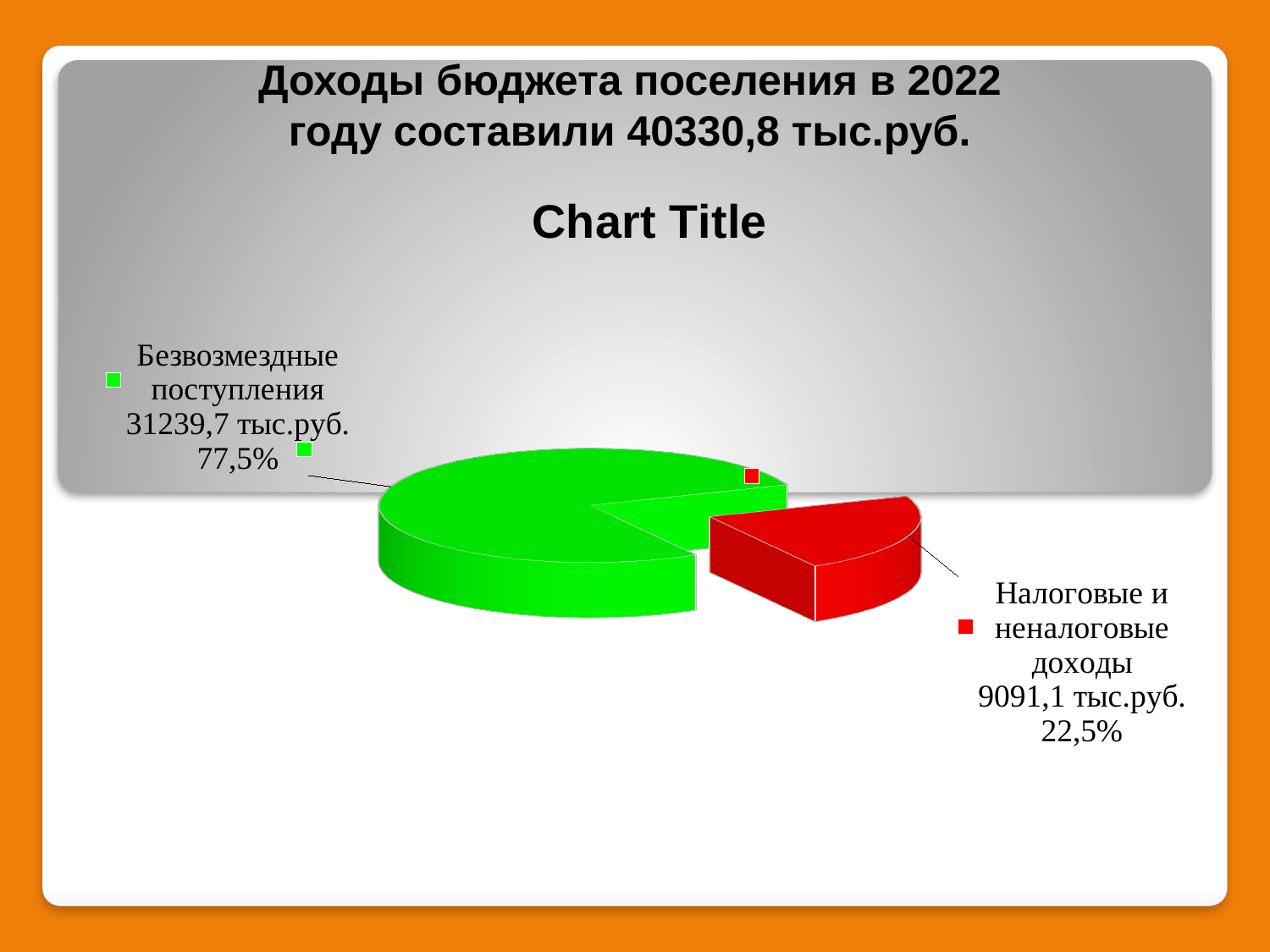
Which is larger: Безвозмездные поступления or Налоговые и неналоговые доходы? Безвозмездные поступления What is the difference in percentage points between the share of Безвозмездные поступления and the share of Налоговые и неналоговые доходы? 55 percentage points What is the title printed above the pie chart? Chart Title Which category has the smallest slice of the pie? Налоговые и неналоговые доходы What colour is the slice for Налоговые и неналоговые доходы? red What share of the pie does Налоговые и неналоговые доходы represent? 22,5% What is the value shown for Безвозмездные поступления? 31239,7 тыс.руб. What kind of chart is shown on the slide? pie chart What share of the pie does Безвозмездные поступления represent? 77,5% How many slices does the pie chart have? 2 Which category has the largest slice of the pie? Безвозмездные поступления What is the value shown for Налоговые и неналоговые доходы? 9091,1 тыс.руб.